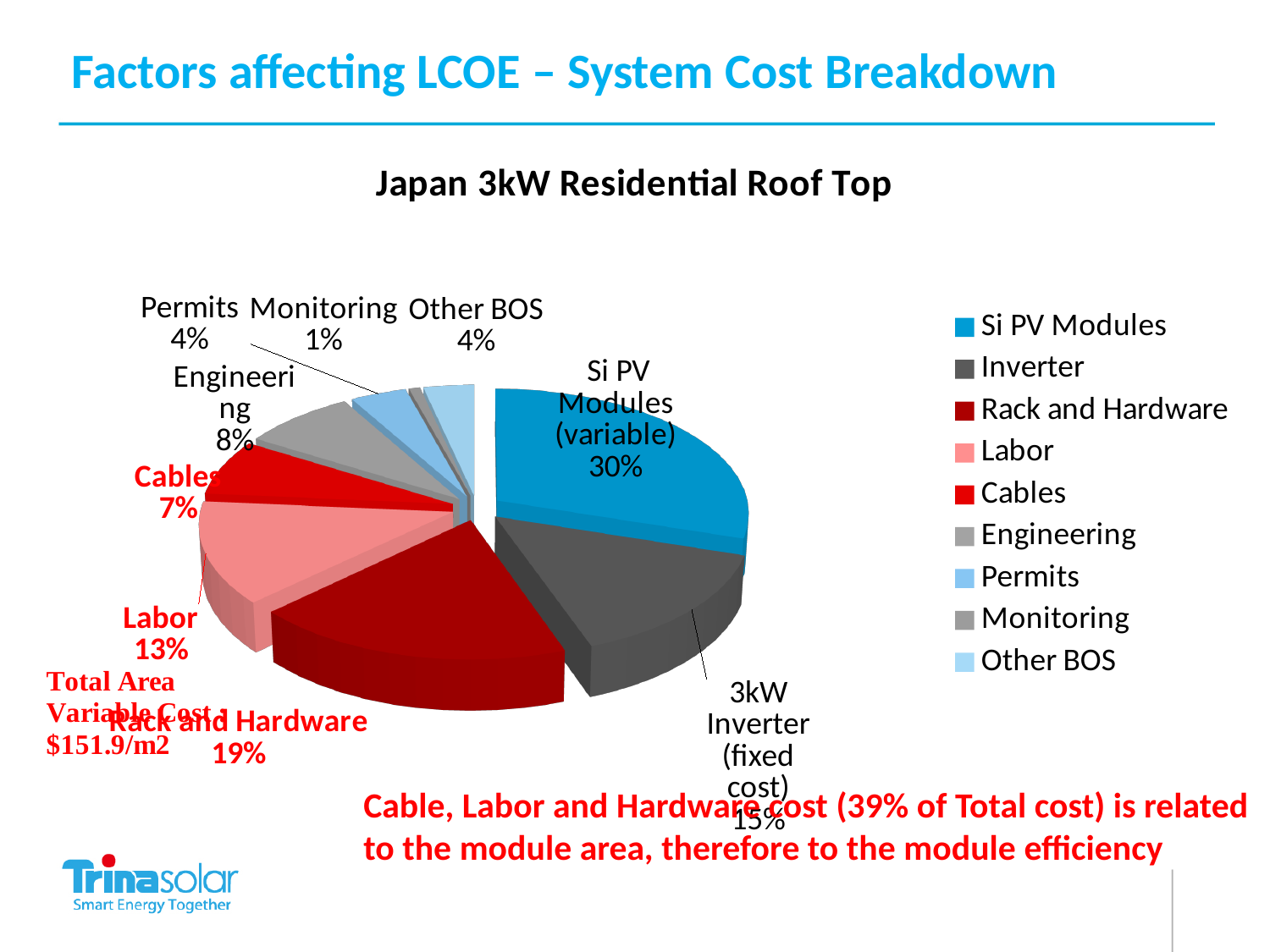
What share of the pie is Si PV Modules? 30% What percentage is shown for the 3kW Inverter (fixed cost)? 15% What type of chart is shown on the slide? Pie chart What percentage is shown for Labor? 13% How many entries does the legend list? 9 Which category has the smallest share of the pie? Monitoring What percentage is shown for Engineering? 8% What is the title of the chart? Japan 3kW Residential Roof Top What percentage is shown for Rack and Hardware? 19% Which is larger, the share for Cables or the share for Engineering? Engineering What is the difference in percentage points between Rack and Hardware and Labor? 6 Which category has the largest share of the pie? Si PV Modules